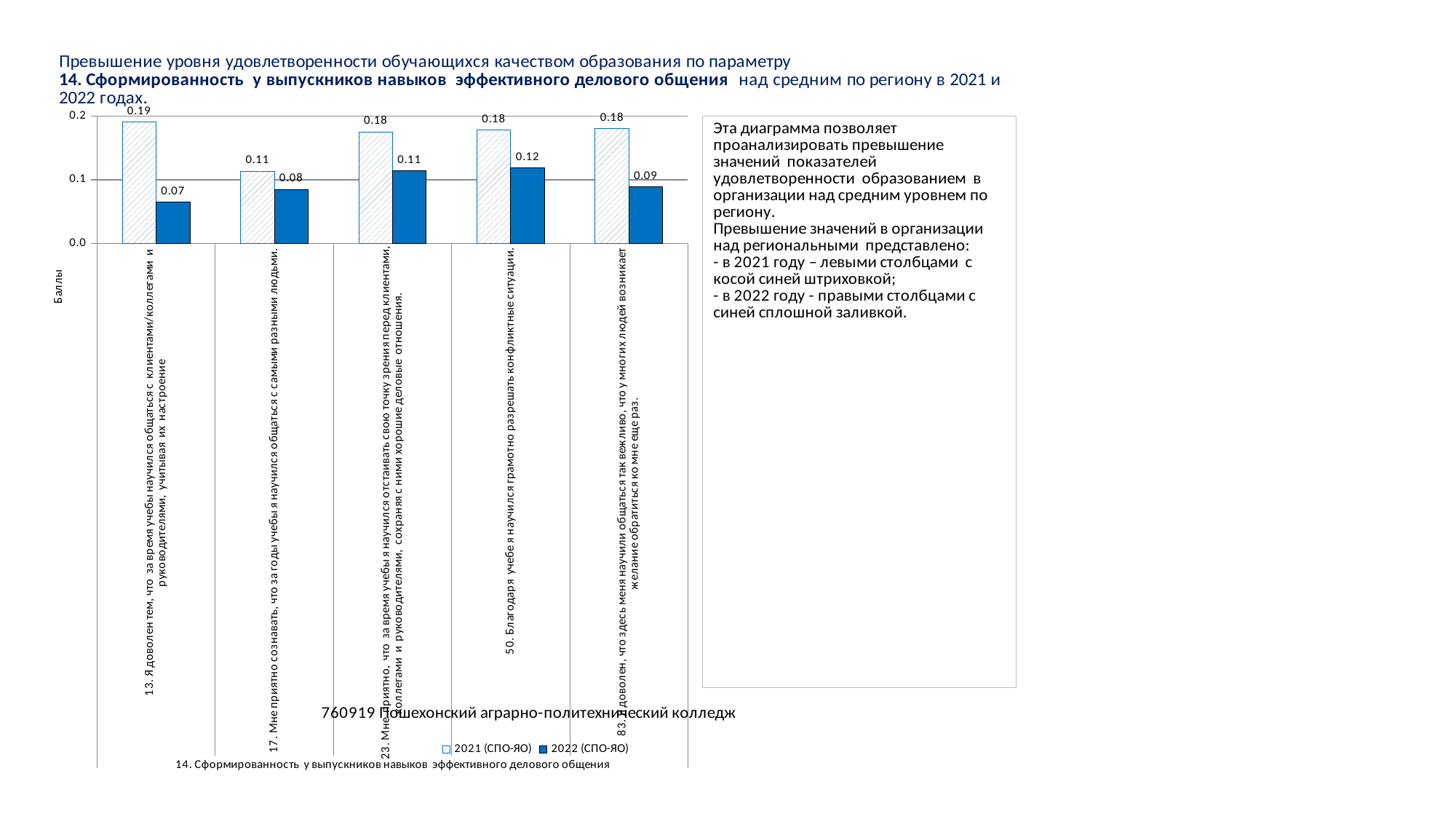
What kind of chart is shown on the slide? Bar chart Which statement has the lowest 2022 (СПО-ЯО) value? 13. Я доволен тем, что за время учебы научился общаться с клиентами/коллегами и руководителями, учитывая их настроение What is the difference between the 2021 and 2022 values for statement 13? 0.12 How many statements (categories) are shown on the x axis of the chart? 5 What is the 2022 (СПО-ЯО) value for statement 17 ("Мне приятно сознавать, что за годы учебы я научился общаться с самыми разными людьми")? 0.08 Which series is drawn with diagonal blue hatching? 2021 (СПО-ЯО) What is the difference between the 2021 and 2022 values for statement 83? 0.09 What is the 2022 (СПО-ЯО) value for statement 50 ("Благодаря учебе я научился грамотно разрешать конфликтные ситуации")? 0.12 What is the 2021 (СПО-ЯО) value for statement 13 ("Я доволен тем, что за время учебы научился общаться с клиентами/коллегами и руководителями...")? 0.19 Which statement has the highest 2021 (СПО-ЯО) value? 13. Я доволен тем, что за время учебы научился общаться с клиентами/коллегами и руководителями, учитывая их настроение How many series does the chart legend list? 2 For statement 23, which is larger: the 2021 (СПО-ЯО) value or the 2022 (СПО-ЯО) value? 2021 (СПО-ЯО)